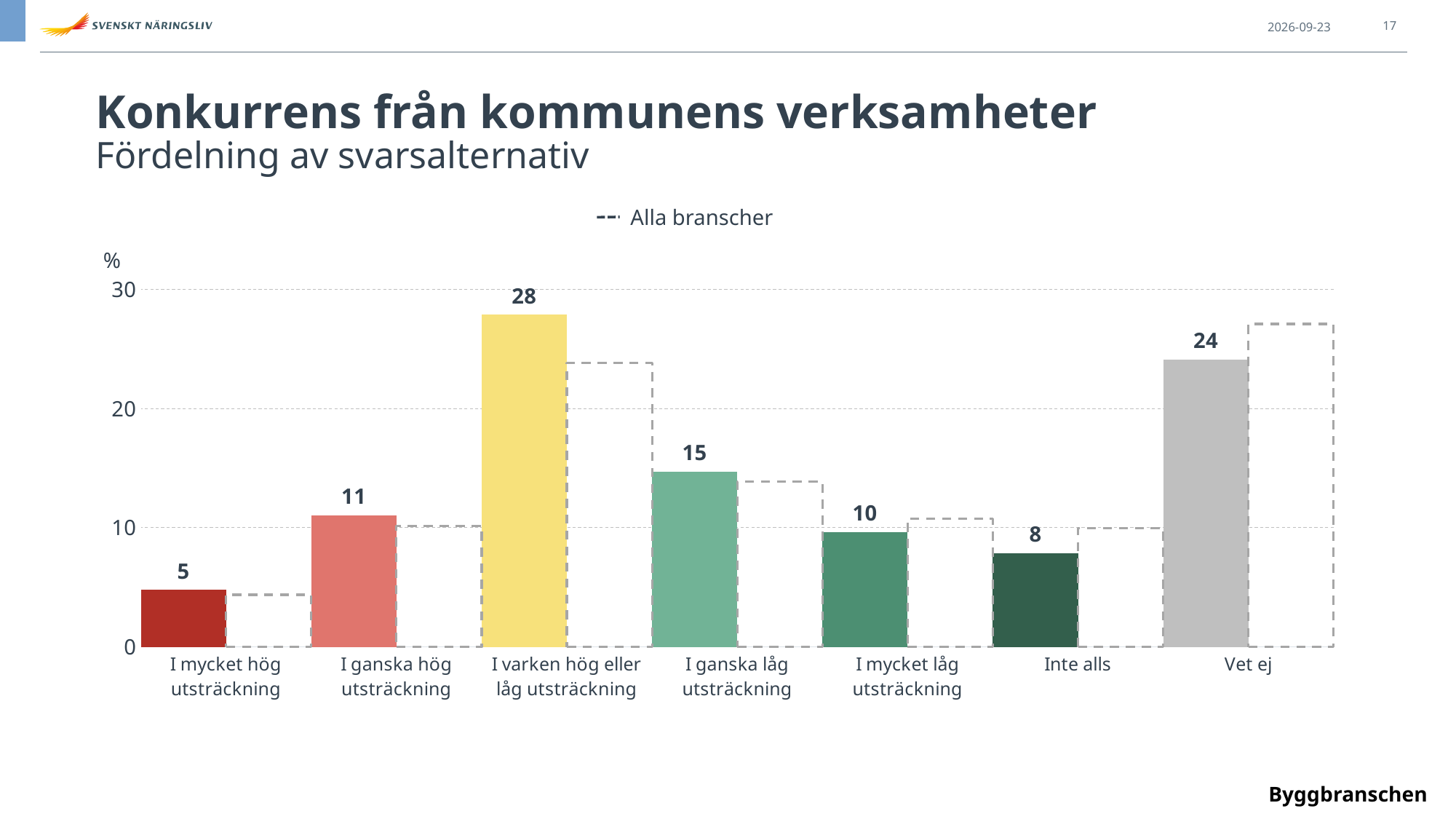
Which category has the highest value? I varken hög eller låg utsträckning How many series does the legend list? 1 What is the difference between the values for "I varken hög eller låg utsträckning" and "Vet ej"? 4 What is the difference between the values for "I ganska hög utsträckning" and "I mycket hög utsträckning"? 6 What is the value for "Vet ej"? 24 Which category has the lowest value? I mycket hög utsträckning What is the value for "I varken hög eller låg utsträckning"? 28 How many categories are shown on the x axis? 7 What is the value for "Inte alls"? 8 Which is larger, the value for "Vet ej" or the value for "I ganska låg utsträckning"? Vet ej What kind of chart is shown on the slide? bar chart Is the dashed "Alla branscher" value for "Vet ej" greater or less than 20? greater